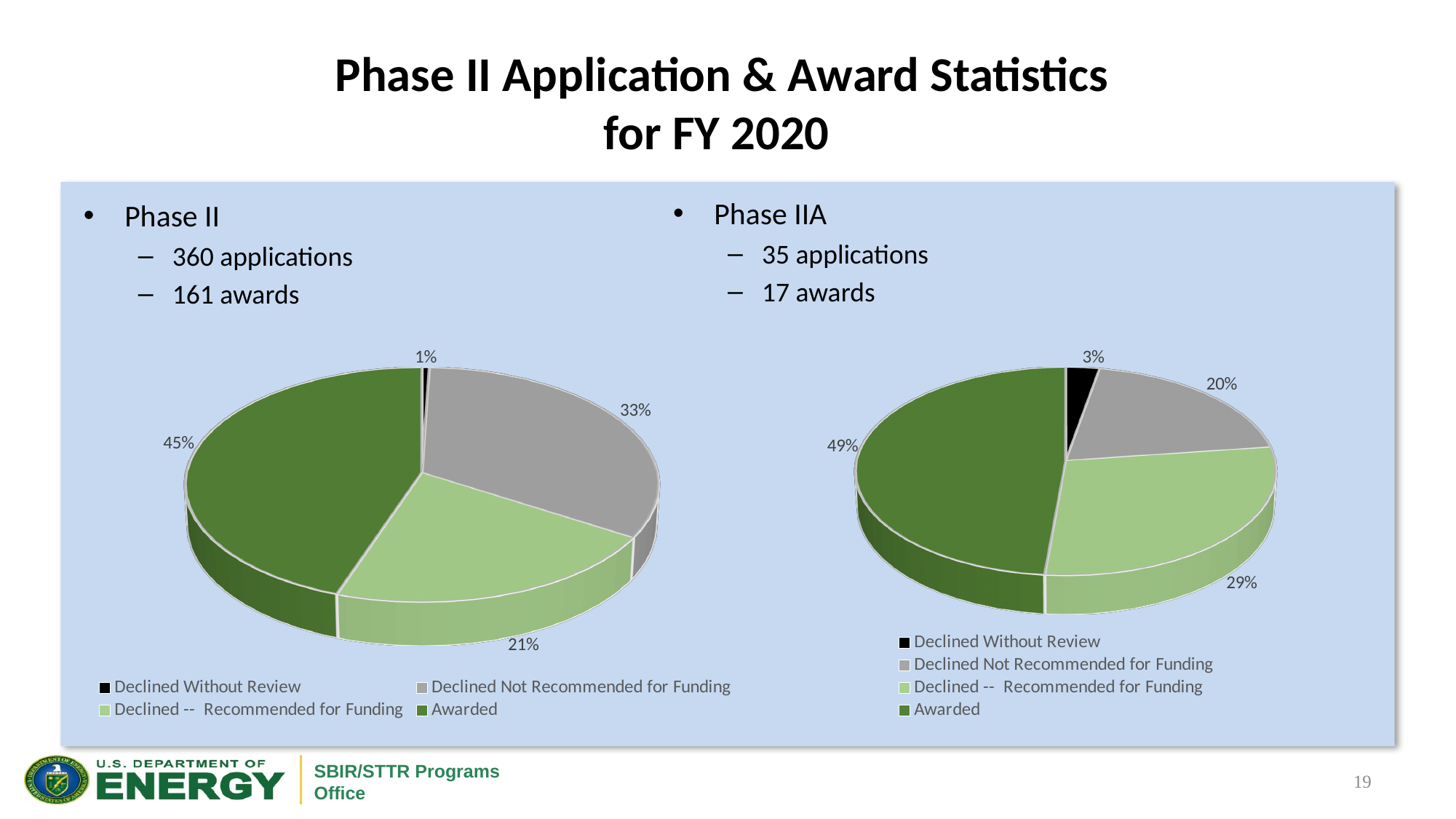
How many categories does the legend of the Phase IIA pie chart on the right list? 4 In the Phase IIA pie chart on the right, what share is Awarded? 49% In the Phase II pie chart on the left, what share is Declined Not Recommended for Funding? 33% In the Phase IIA pie chart on the right, what is the difference in percentage points between Awarded and Declined Not Recommended for Funding? 29 In the Phase II pie chart on the left, what share is Awarded? 45% In the Phase IIA pie chart on the right, which category has the largest slice? Awarded In the Phase II pie chart on the left, which category has the smallest slice? Declined Without Review In the Phase II pie chart on the left, which is larger: Declined Not Recommended for Funding or Declined -- Recommended for Funding? Declined Not Recommended for Funding